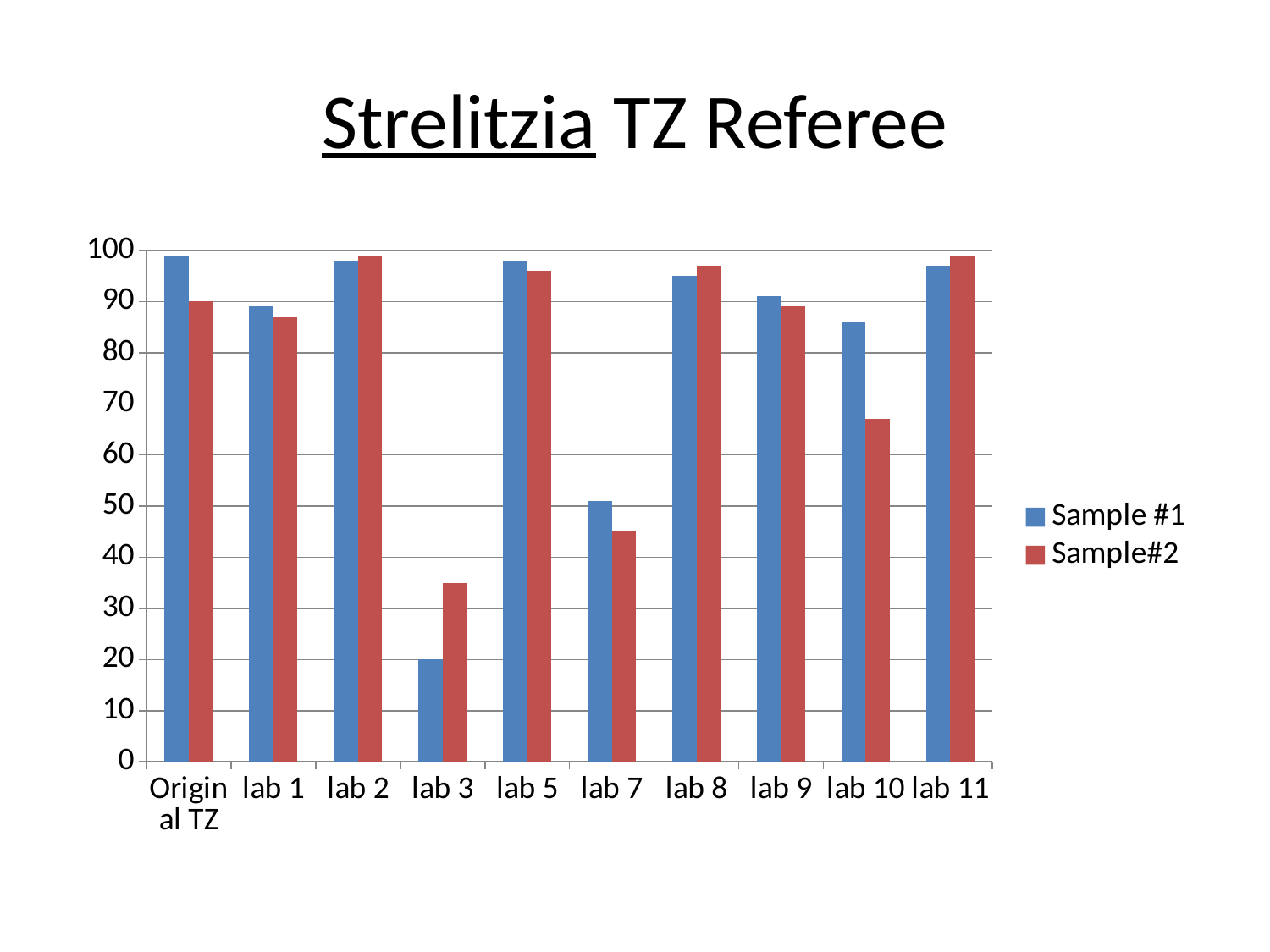
Which category has the lowest Sample #1 value? lab 3 For lab 3, which is larger: Sample #1 or Sample#2? Sample#2 How many categories are shown on the x axis? 10 What is the Sample #1 value for lab 3? 20 What is the title of the chart's slide? Strelitzia TZ Referee What is the Sample#2 value for Original TZ? 90 Is the Sample#2 value for lab 10 greater or less than 70? less Is the Sample#2 value for lab 7 greater or less than 50? less For lab 10, which is larger: Sample #1 or Sample#2? Sample #1 What kind of chart is shown on the slide? bar chart Which category has the lowest Sample#2 value? lab 3 How many series does the legend list? 2